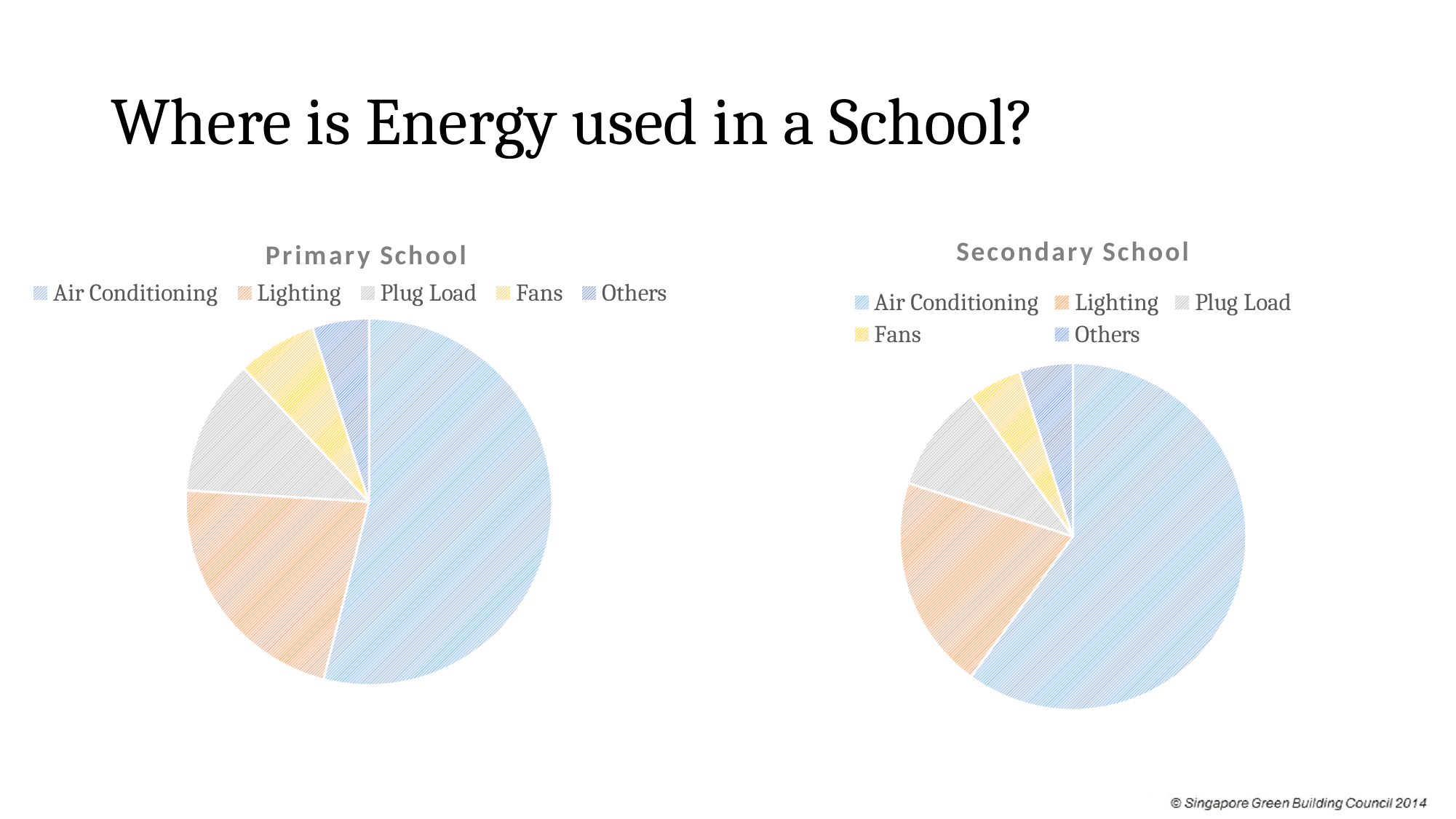
What is the title of the pie chart on the left of the slide? Primary School In the Primary School chart, which slice is larger, Lighting or Plug Load? Lighting How many slices does the Secondary School pie chart have? 5 In the Primary School chart, which category has the largest slice? Air Conditioning In the Primary School chart, which category has the smallest slice? Others In the Secondary School chart, which category has the largest slice? Air Conditioning What kind of chart is the Secondary School chart? pie chart How many slices does the Primary School pie chart have? 5 In the Secondary School chart, which slice is larger, Air Conditioning or Lighting? Air Conditioning In the Secondary School chart, which slice is larger, Plug Load or Fans? Plug Load How many entries does the legend of the Secondary School chart list? 5 What kind of chart is the Primary School chart? pie chart